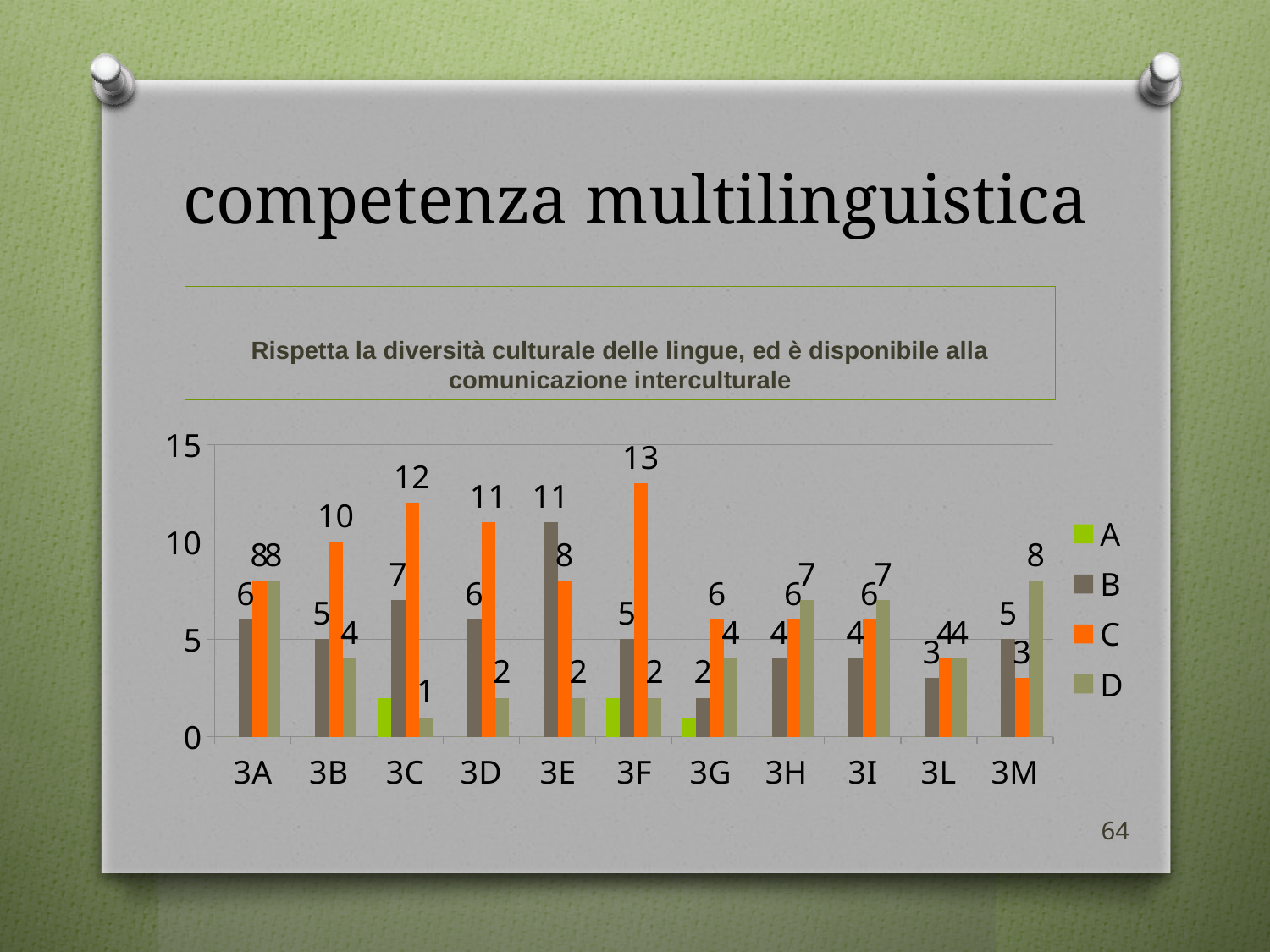
How many categories are shown on the x axis of the chart? 11 What is the value of series C for category 3F? 13 What is the value of series D for category 3M? 8 Which category has the lowest value for series D? 3C Which category has the highest value for series C? 3F What kind of chart is shown on the slide? bar chart What is the value of series B for category 3E? 11 What is the title of the slide containing the chart? competenza multilinguistica What is the difference between series C and series D for category 3C? 11 For category 3M, which is larger: series B or series C? B How many series does the chart legend list? 4 What is the value of series C for category 3B? 10